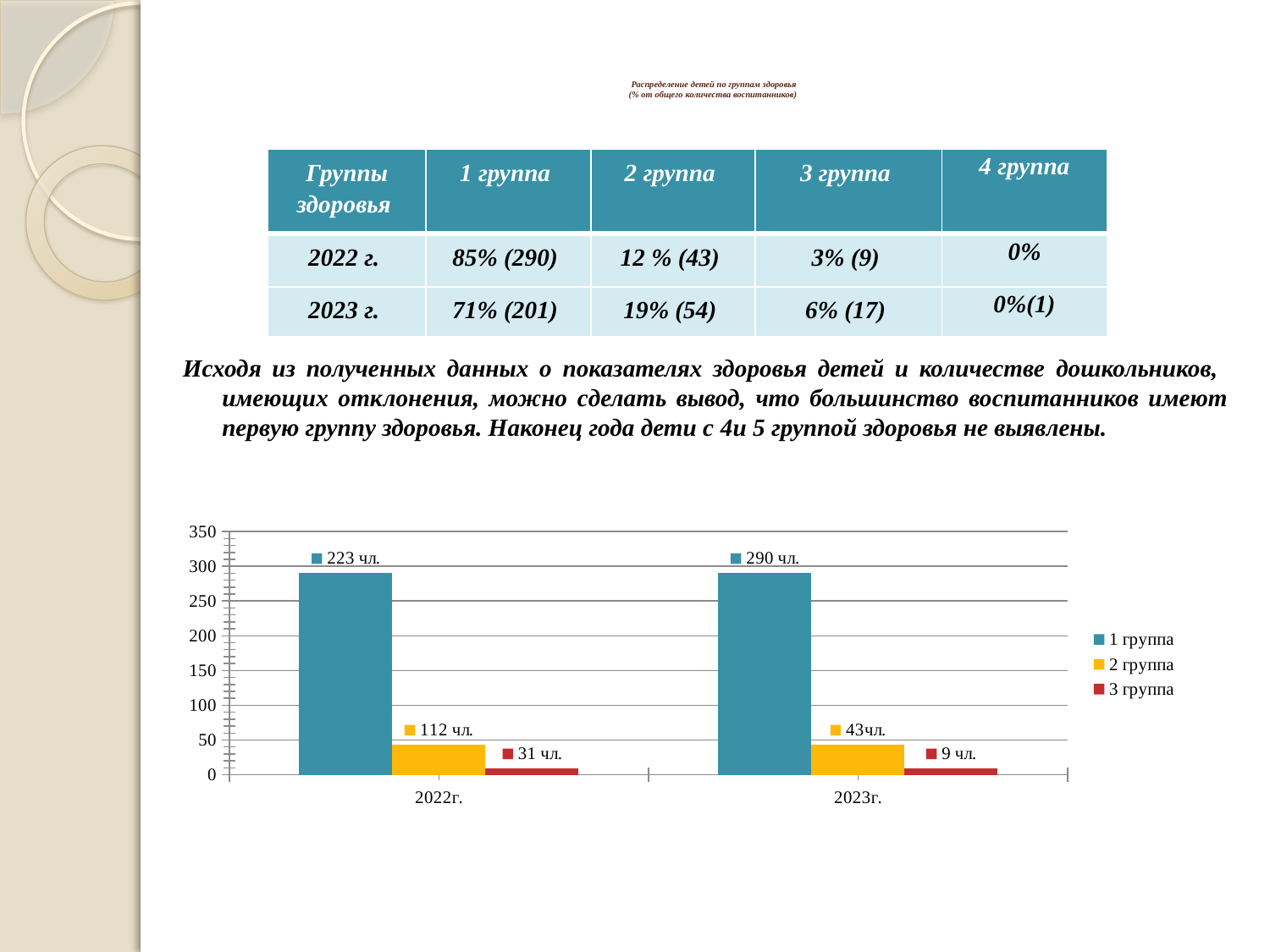
What is the data label for 1 группа in 2022г.? 223 чл. How many series does the chart legend list? 3 What is the data label for 3 группа in 2023г.? 9 чл. Which series has the highest value in 2023г.? 1 группа Which series has the lowest value in 2022г.? 3 группа How many categories are shown on the x axis of the chart? 2 What is the data label for 1 группа in 2023г.? 290 чл. What is the data label for 3 группа in 2022г.? 31 чл. What is the difference between the labelled values for 1 группа and 2 группа in 2023г.? 247 Which series is shown in yellow in the chart legend? 2 группа What type of chart is shown on the slide? bar chart What is the data label for 2 группа in 2022г.? 112 чл.